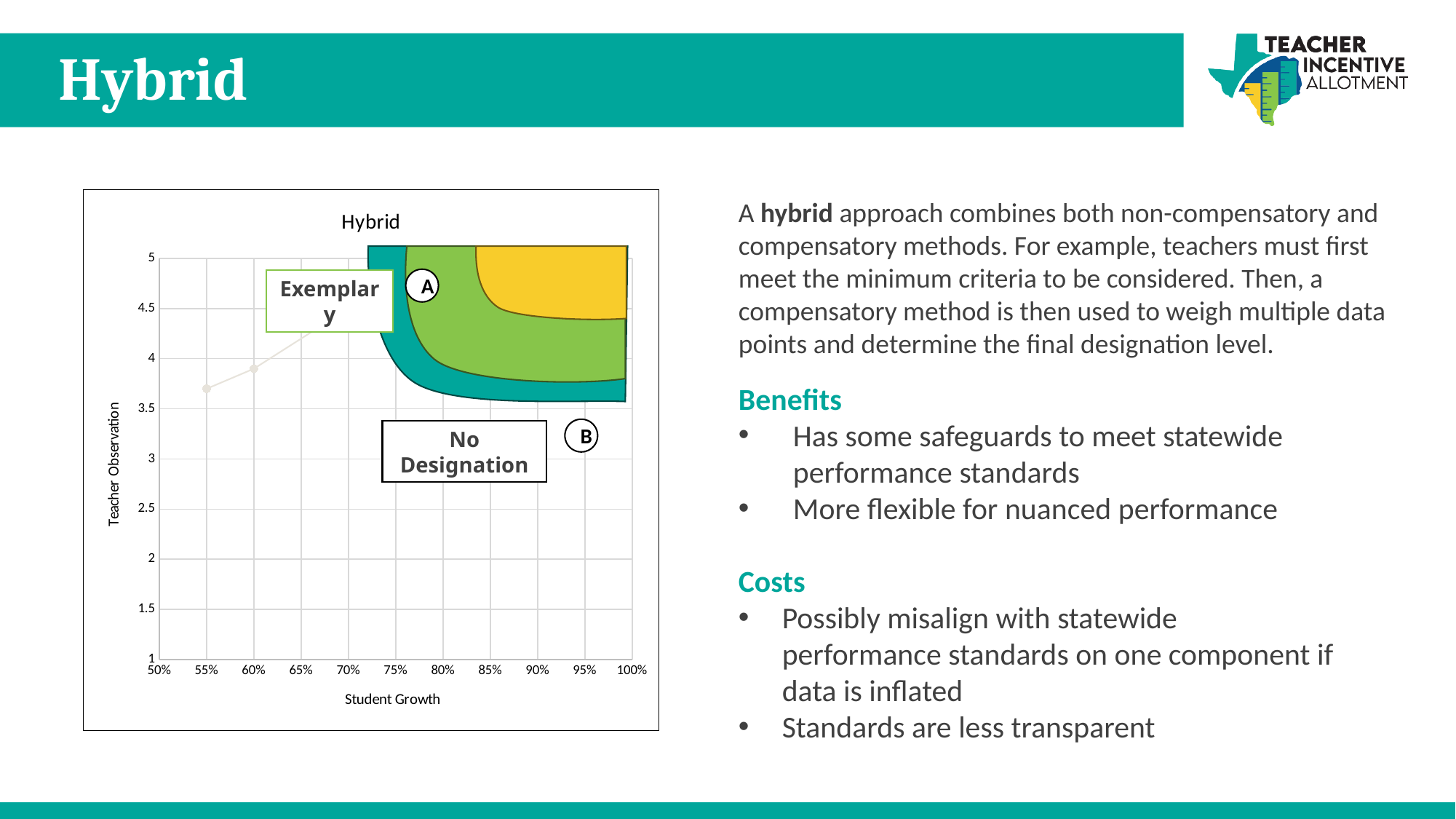
How many tick labels are shown on the Student Growth axis? 11 What is the lowest value shown on the Student Growth axis? 50% How many tick labels are shown on the Teacher Observation axis? 9 Which point has the higher Teacher Observation value, A or B? A Is the Teacher Observation value for point A greater or less than 4.5? greater What is the label on the vertical axis of the chart? Teacher Observation Which point has the higher Student Growth value, A or B? B Is the Student Growth value for point A greater or less than 85%? less Is the Student Growth value for point B greater or less than 90%? greater What is the highest value shown on the Teacher Observation axis? 5 What is the title of the chart? Hybrid